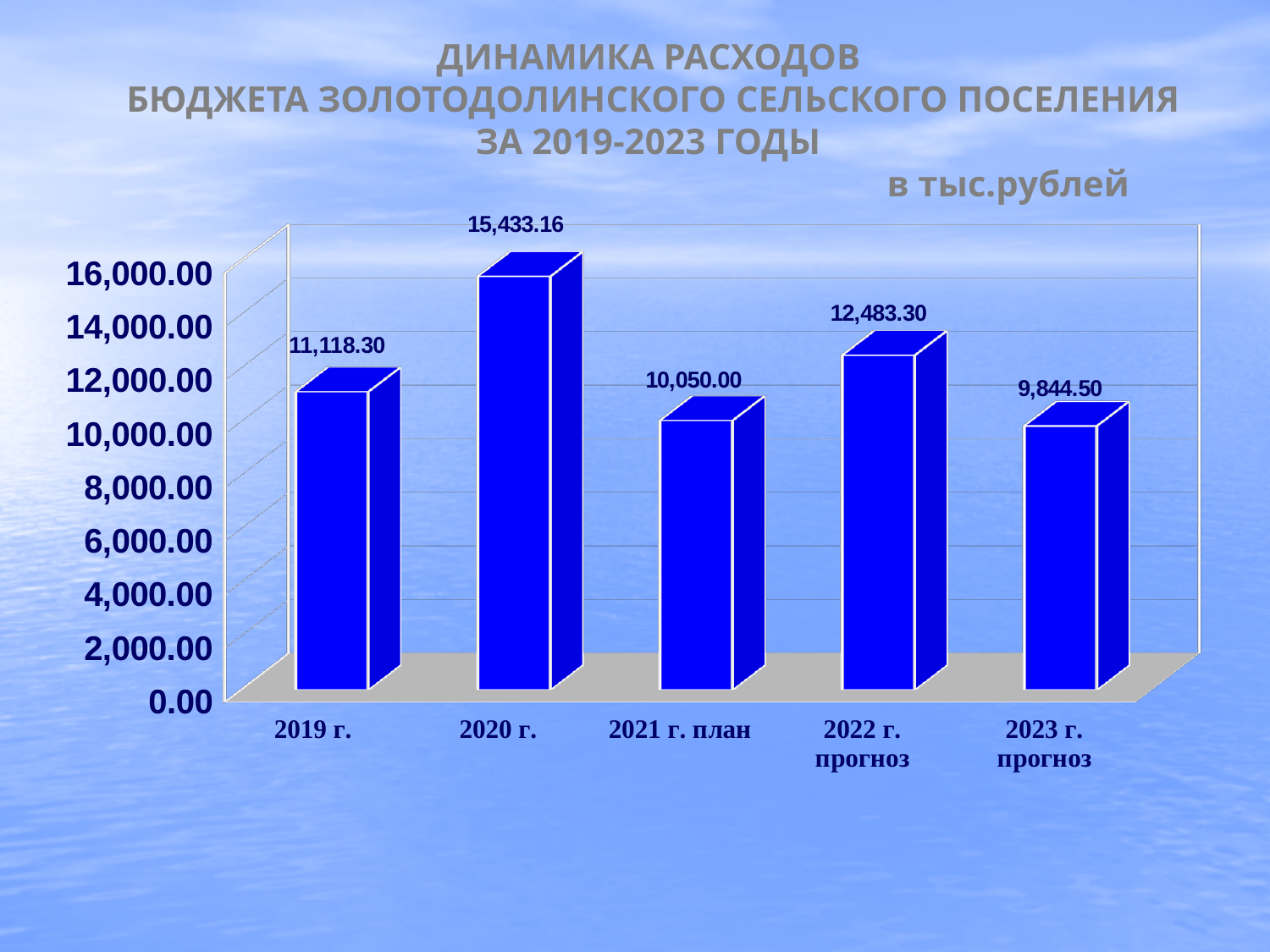
Which is larger, the value for 2022 г. прогноз or the value for 2019 г.? 2022 г. прогноз What is the value for 2019 г.? 11,118.30 What is the value for 2023 г. прогноз? 9,844.50 What kind of chart is shown on the slide? bar chart Which category has the highest value? 2020 г. How many categories are shown on the x axis? 5 What is the difference between the values for 2022 г. прогноз and 2021 г. план? 2,433.30 In what units are the values on the chart expressed? тыс.рублей What is the value for 2021 г. план? 10,050.00 Is the value for 2020 г. greater or less than 14,000.00? greater Which category has the lowest value? 2023 г. прогноз What is the difference between the values for 2020 г. and 2019 г.? 4,314.86